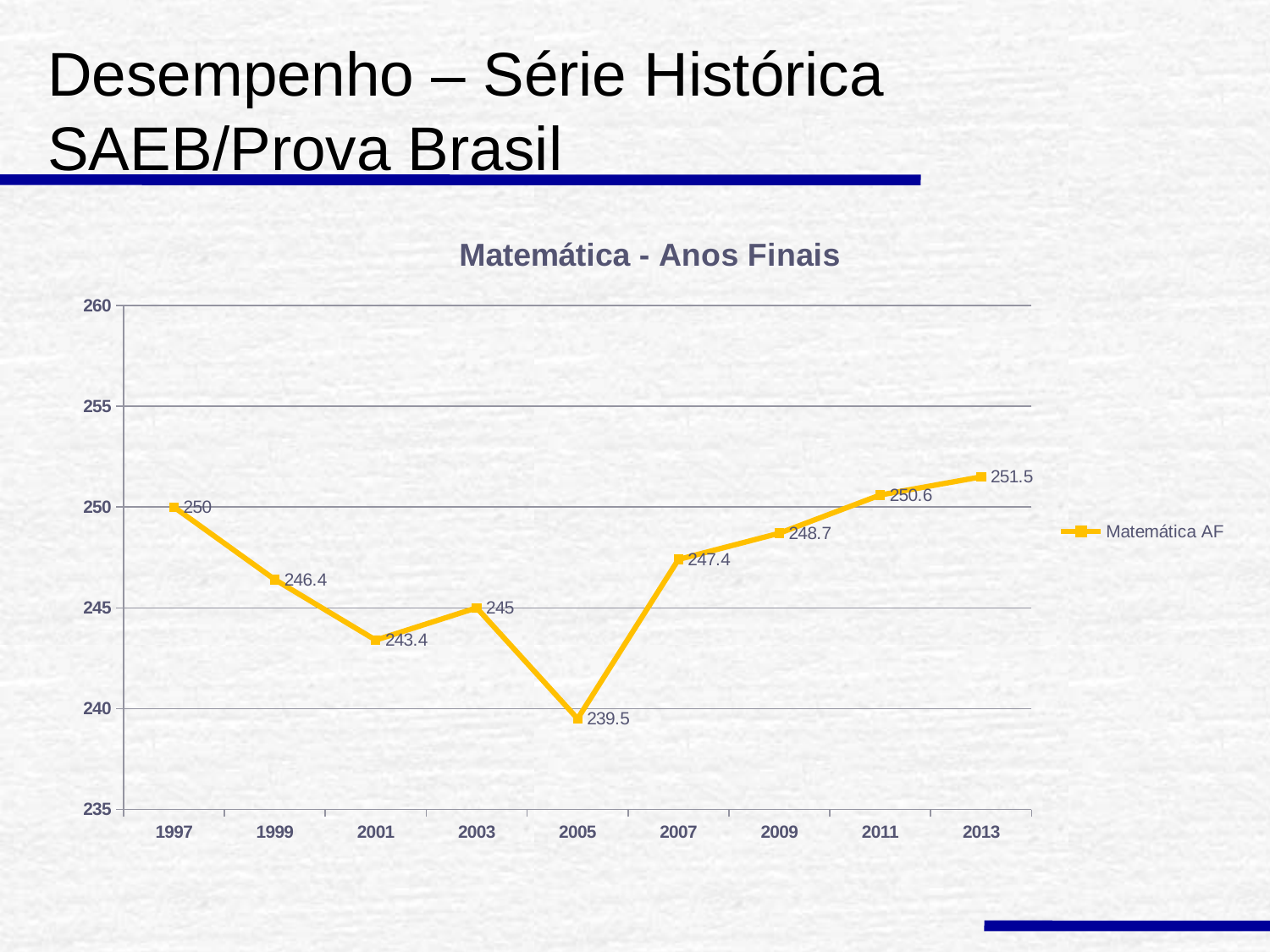
What kind of chart is shown? line chart Is the value for 2001 greater or less than 245? less What is the difference between the values for 2013 and 2005? 12 Which year has the lowest value? 2005 What is the value for 2005? 239.5 What is the value for 1997? 250 What is the value for 2011? 250.6 Do the values rise or fall from 2005 to 2013? rise Which year has the highest value? 2013 How many series does the legend list? 1 How many years are plotted on the x axis? 9 Which is larger, the value for 1999 or the value for 2003? 1999